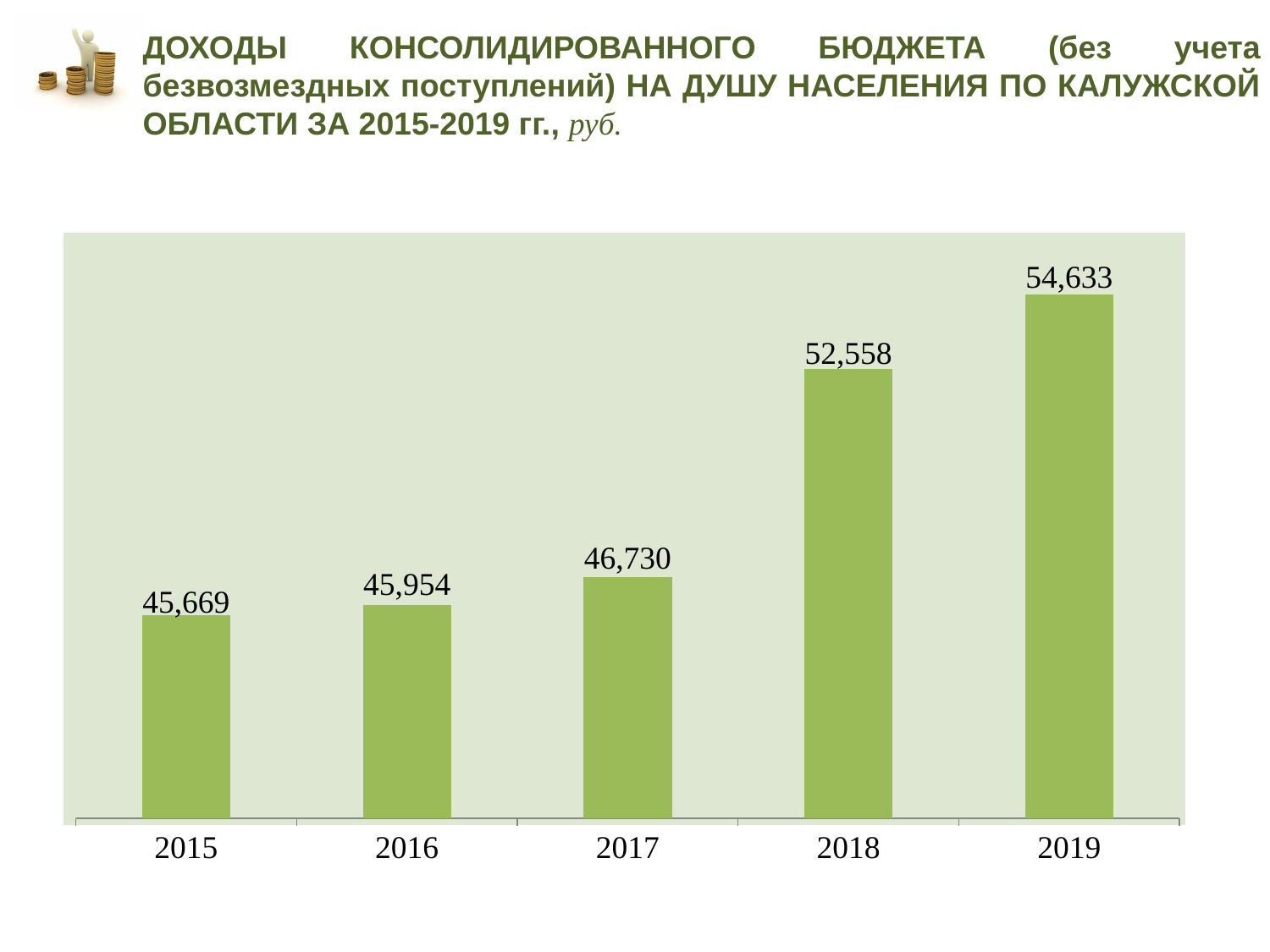
What is the value for 2017? 46,730 What is the value for 2019? 54,633 Which is larger, the value for 2016 or the value for 2018? 2018 What is the difference between the values for 2019 and 2018? 2,075 Which year has the lowest value? 2015 What is the difference between the values for 2018 and 2017? 5,828 Which year has the highest value? 2019 Do the values rise or fall from 2015 to 2019? rise What colour are the bars in the chart? green What is the value for 2015? 45,669 How many years are shown on the x axis? 5 What kind of chart is shown on the slide? bar chart